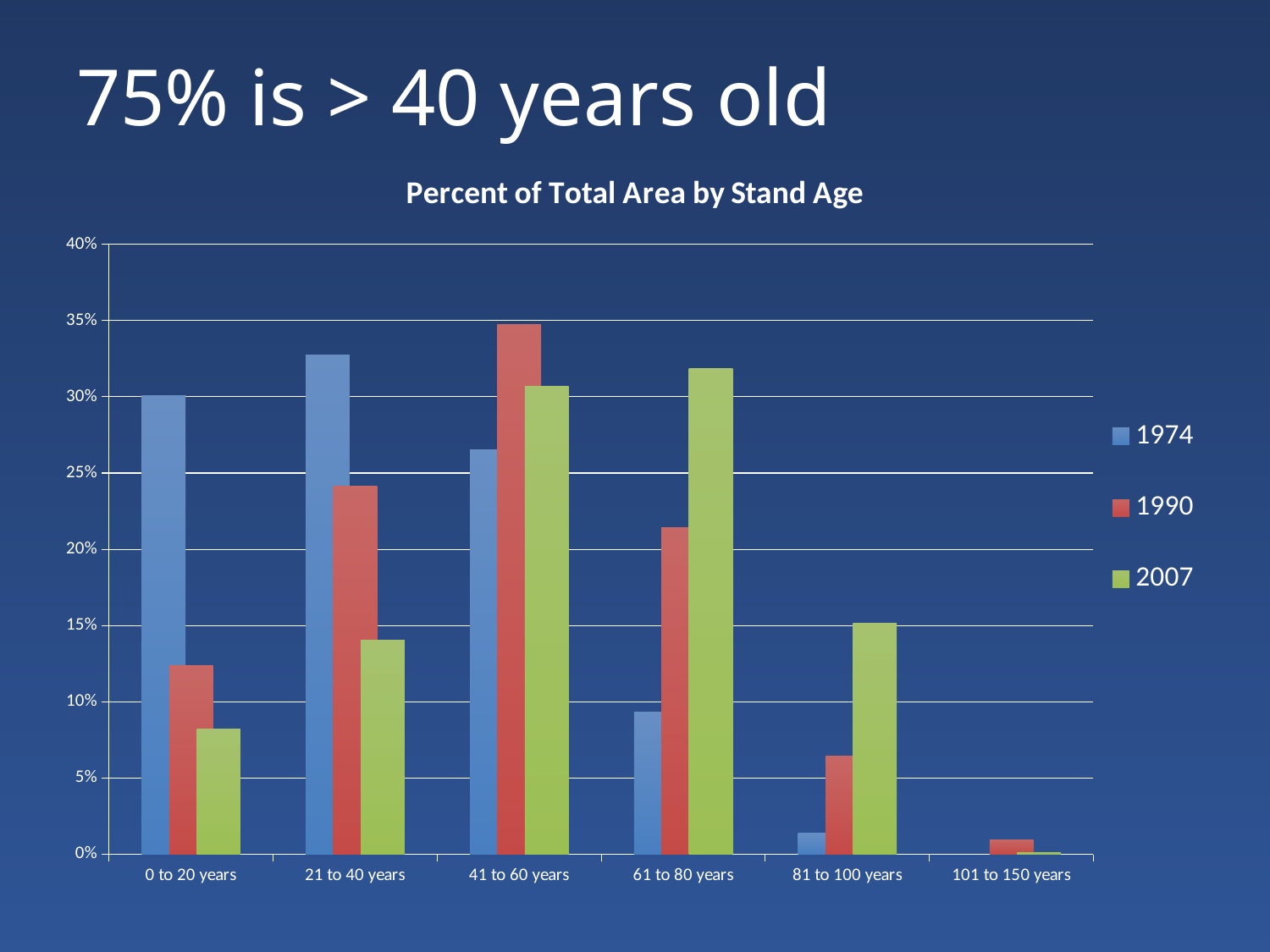
What kind of chart is shown on the slide? bar chart Is the 2007 value for 81 to 100 years greater or less than 10%? greater How many series does the legend list? 3 For the 2007 series, which stand age category has the highest value? 61 to 80 years In the 61 to 80 years category, which series has the larger value, 1990 or 2007? 2007 For the 1990 series, which stand age category has the highest value? 41 to 60 years How many stand age categories are shown on the x axis? 6 Which colour represents the 2007 series? green For the 1990 series, which stand age category has the lowest value? 101 to 150 years For the 1974 series, which stand age category has the highest value? 21 to 40 years Is the 1974 value for 0 to 20 years greater or less than 25%? greater What is the title of the chart? Percent of Total Area by Stand Age